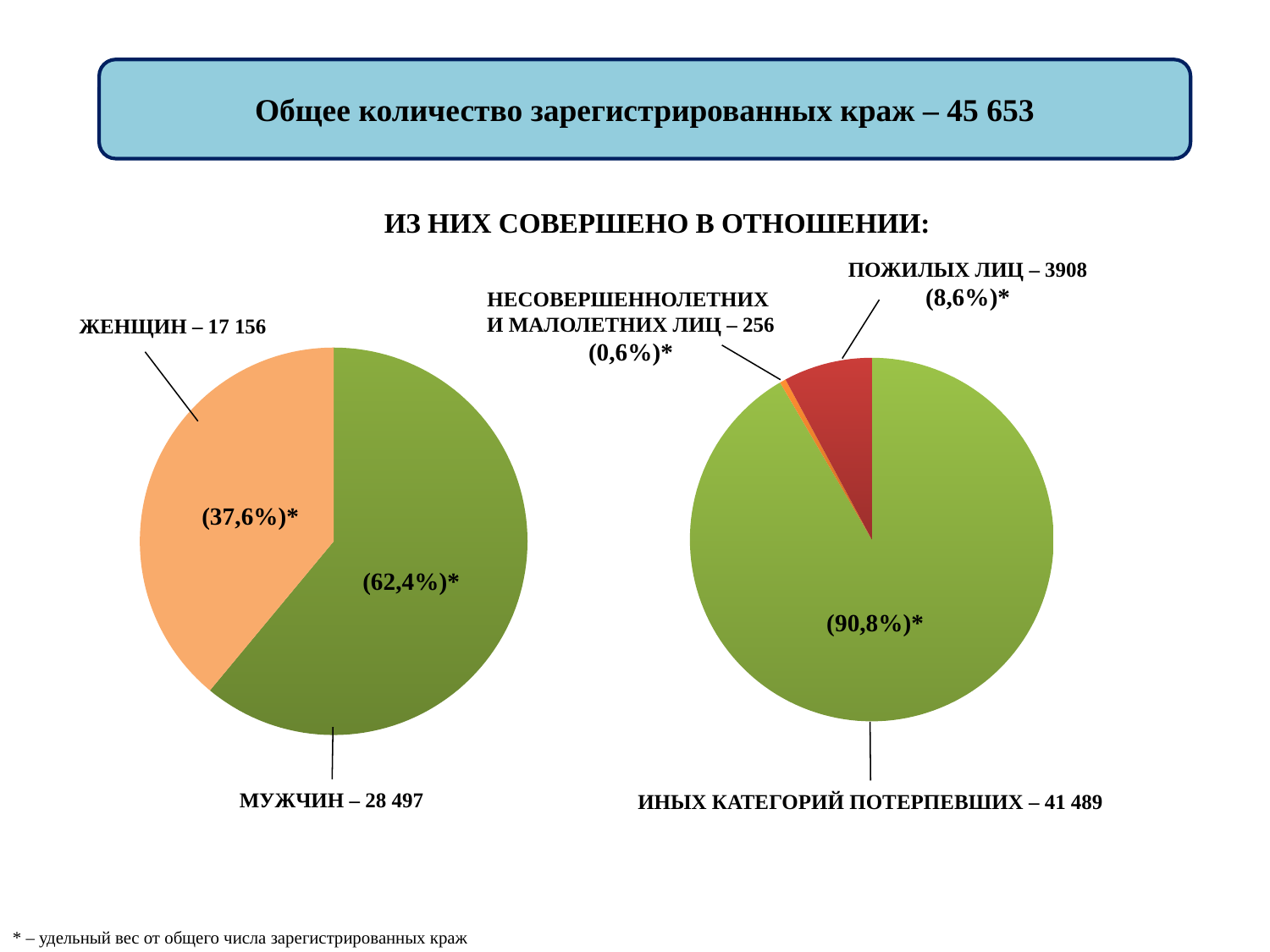
In the left pie chart, what share of the pie does the ЖЕНЩИН slice represent? 37,6% In the right pie chart, which category has the smallest value? НЕСОВЕРШЕННОЛЕТНИХ И МАЛОЛЕТНИХ ЛИЦ In the left pie chart, which category is larger, ЖЕНЩИН or МУЖЧИН? МУЖЧИН In the left pie chart, what is the value for ЖЕНЩИН? 17 156 In the left pie chart, what share of the pie does the МУЖЧИН slice represent? 62,4% In the left pie chart, what is the value for МУЖЧИН? 28 497 In the right pie chart, what is the value for НЕСОВЕРШЕННОЛЕТНИХ И МАЛОЛЕТНИХ ЛИЦ? 256 In the left pie chart, what is the difference between the values for МУЖЧИН and ЖЕНЩИН? 11 341 In the right pie chart, what is the value for ПОЖИЛЫХ ЛИЦ? 3908 How many slices does the right pie chart have? 3 In the right pie chart, what share of the pie does the ИНЫХ КАТЕГОРИЙ ПОТЕРПЕВШИХ slice represent? 90,8% What type of chart is shown on the left side of the slide? pie chart